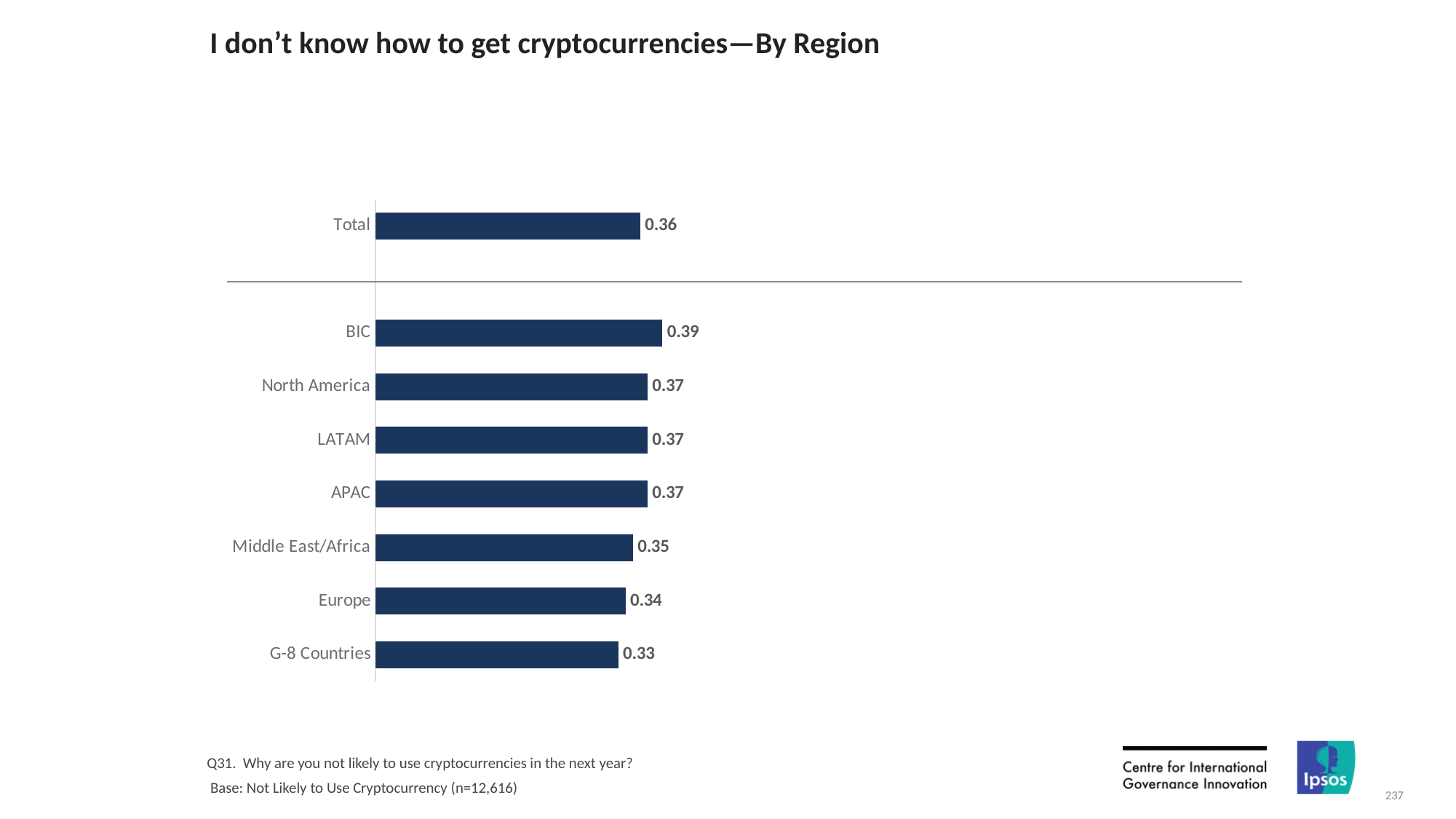
How many categories are shown in the chart, including Total? 8 What kind of chart is shown on the slide? Bar chart What is the value for Middle East/Africa? 0.35 Which category has the lowest value? G-8 Countries What is the difference between the values for BIC and G-8 Countries? 0.06 What is the value for Europe? 0.34 What is the difference between the values for North America and Europe? 0.03 What is the title of the chart? I don't know how to get cryptocurrencies—By Region Which region has the highest value? BIC What is the value for BIC? 0.39 What is the value for Total? 0.36 Which is larger, the value for BIC or the value for Europe? BIC